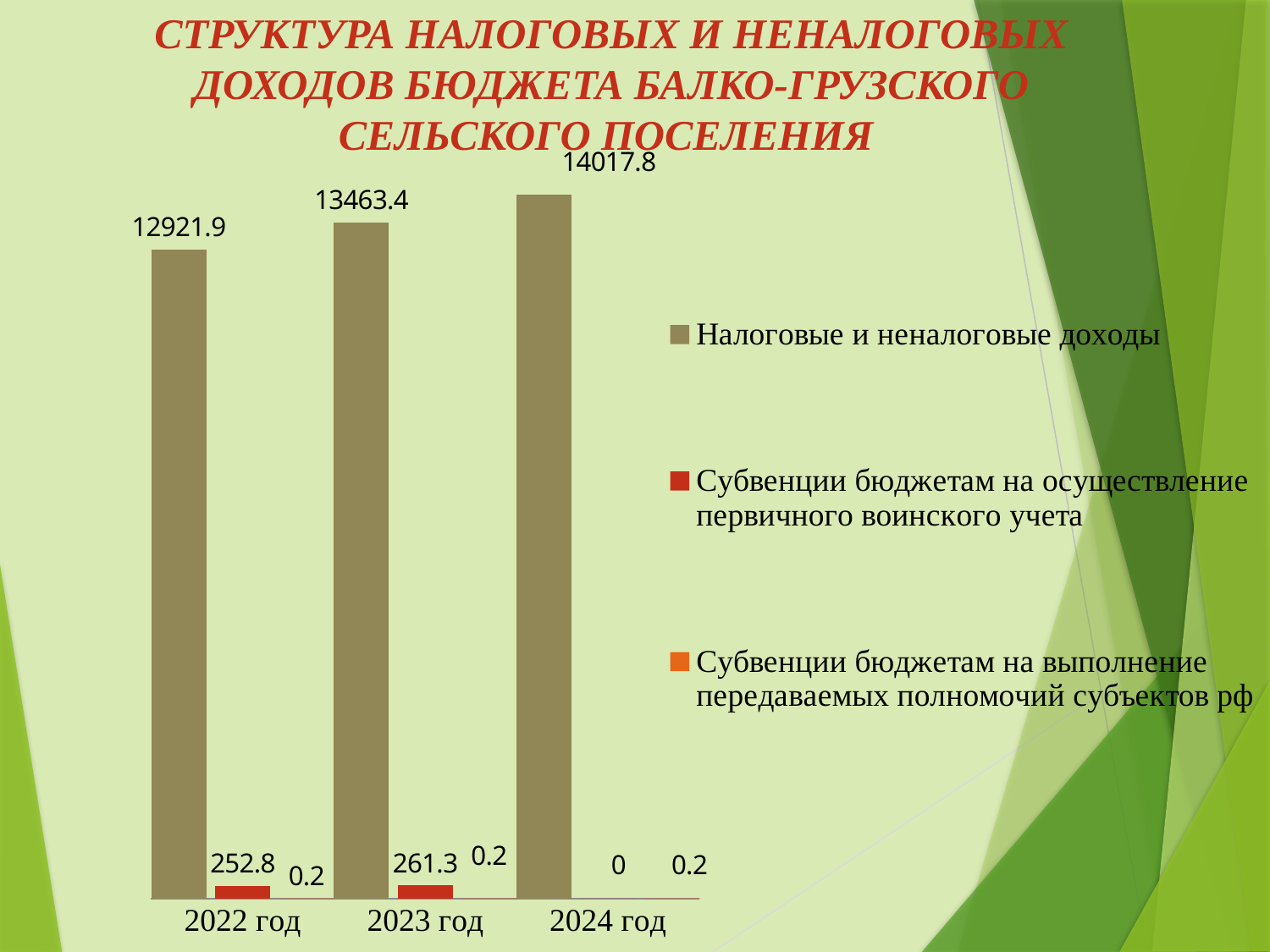
What is the value of Субвенции бюджетам на осуществление первичного воинского учета for 2024 год? 0 What is the value of Субвенции бюджетам на выполнение передаваемых полномочий субъектов рф for 2022 год? 0.2 What is the value of Субвенции бюджетам на осуществление первичного воинского учета for 2023 год? 261.3 What is the value of Налоговые и неналоговые доходы for 2022 год? 12921.9 How many series does the legend list? 3 Which is larger: Субвенции бюджетам на осуществление первичного воинского учета in 2022 год or in 2023 год? 2023 год In which year is Налоговые и неналоговые доходы the highest? 2024 год What is the value of Налоговые и неналоговые доходы for 2024 год? 14017.8 Does Налоговые и неналоговые доходы rise or fall from 2022 год to 2024 год? rise In which year is Налоговые и неналоговые доходы the lowest? 2022 год What is the difference between Налоговые и неналоговые доходы in 2023 год and 2022 год? 541.5 How many years (categories) are shown on the x axis? 3